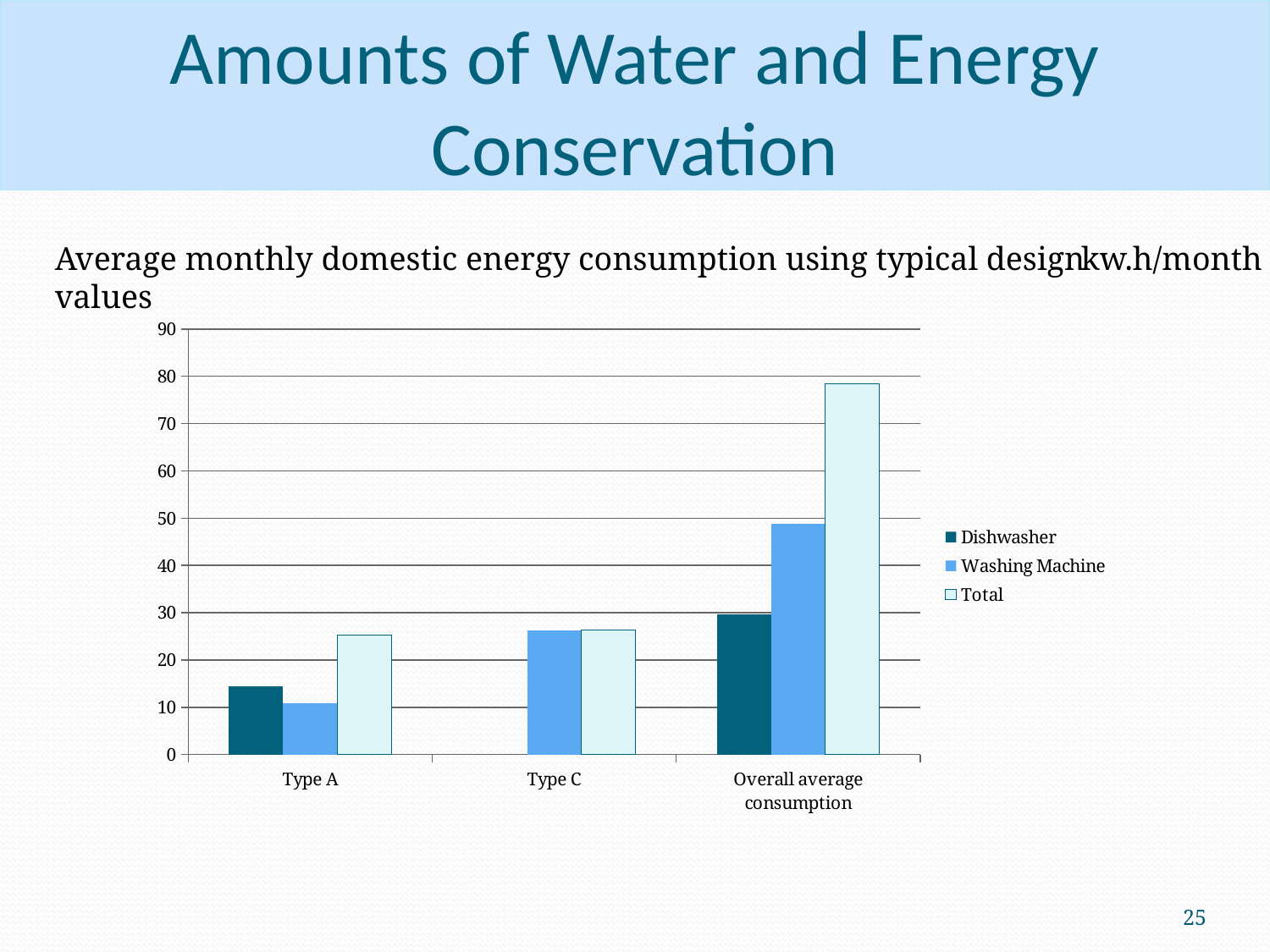
Which is larger for Type A, the Dishwasher value or the Washing Machine value? Dishwasher Which category has the highest Total value? Overall average consumption Is the Total value for Overall average consumption greater or less than 70? greater Do the Total values rise or fall from Type A to Overall average consumption? rise What kind of chart is shown on the slide? bar chart Is the Washing Machine value for Type A greater or less than 20? less Is the Washing Machine value for Overall average consumption greater or less than 40? greater How many categories are shown on the x axis of the chart? 3 What are the three series listed in the chart's legend? Dishwasher, Washing Machine, Total How many series does the chart's legend list? 3 Which category has the lowest Washing Machine value? Type A